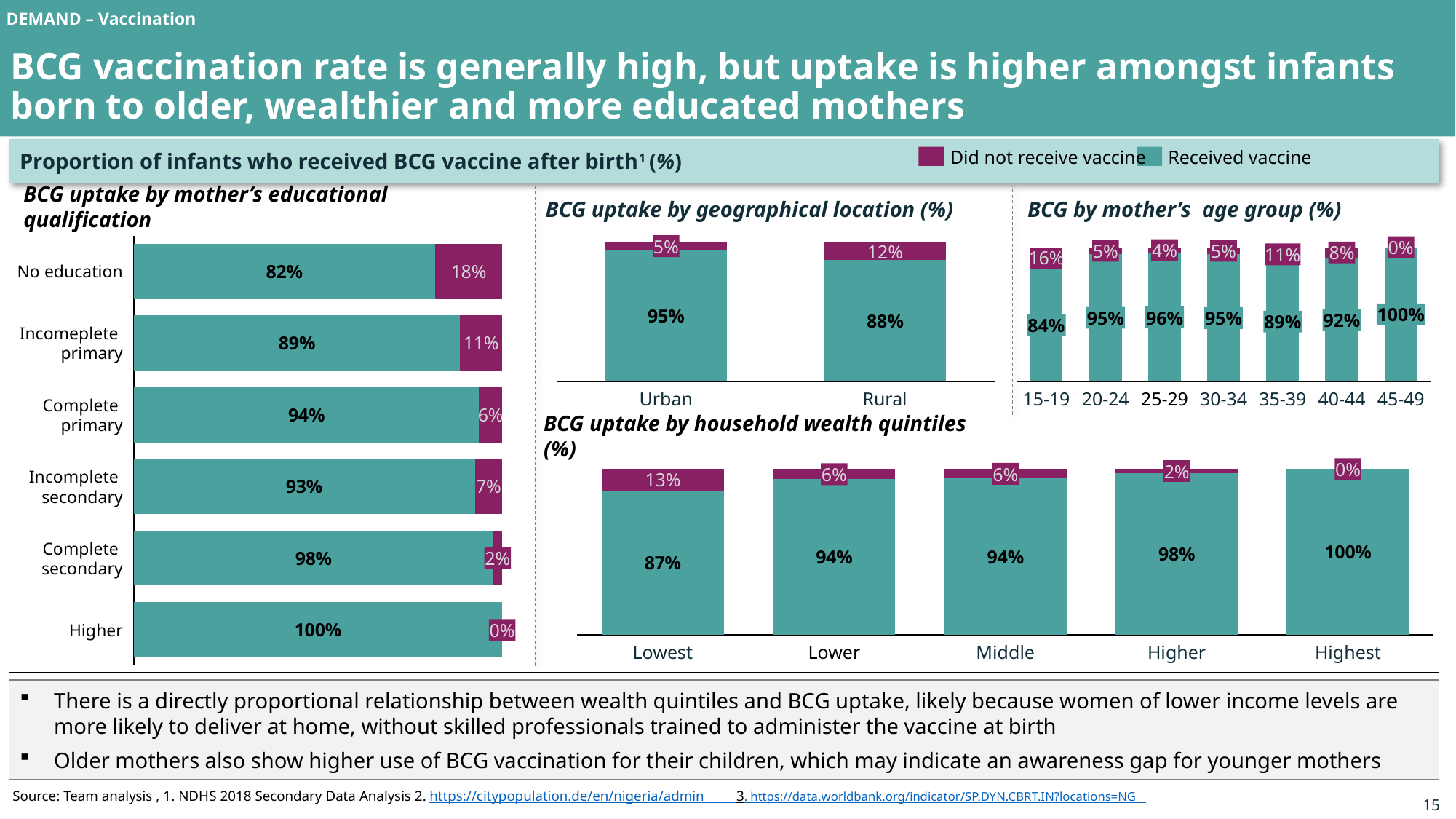
In the 'BCG uptake by mother's educational qualification' chart, how many educational categories are shown? 6 In the 'BCG uptake by household wealth quintiles (%)' chart, is the 'Received vaccine' value larger for the Lowest or the Higher quintile? Higher In the 'BCG uptake by mother's educational qualification' chart, what is the 'Did not receive vaccine' value for Incomplete primary? 11% In the 'BCG uptake by mother's educational qualification' chart, what percentage of infants born to mothers with no education received the vaccine? 82% In the 'BCG uptake by mother's educational qualification' chart, which educational category has the lowest 'Received vaccine' value? No education In the 'BCG uptake by geographical location (%)' chart, what is the 'Received vaccine' value for Rural? 88% In the 'BCG by mother's age group (%)' chart, how many age groups are shown? 7 How many series does the legend at the top of the slide list? 2 In the 'BCG uptake by geographical location (%)' chart, what is the difference between the Urban and Rural 'Received vaccine' values? 7% In the 'BCG by mother's age group (%)' chart, what is the 'Received vaccine' value for the 35-39 age group? 89% In the 'BCG uptake by household wealth quintiles (%)' chart, what is the 'Did not receive vaccine' value for the Lowest quintile? 13% In the 'BCG by mother's age group (%)' chart, which age group has the highest 'Did not receive vaccine' value? 15-19